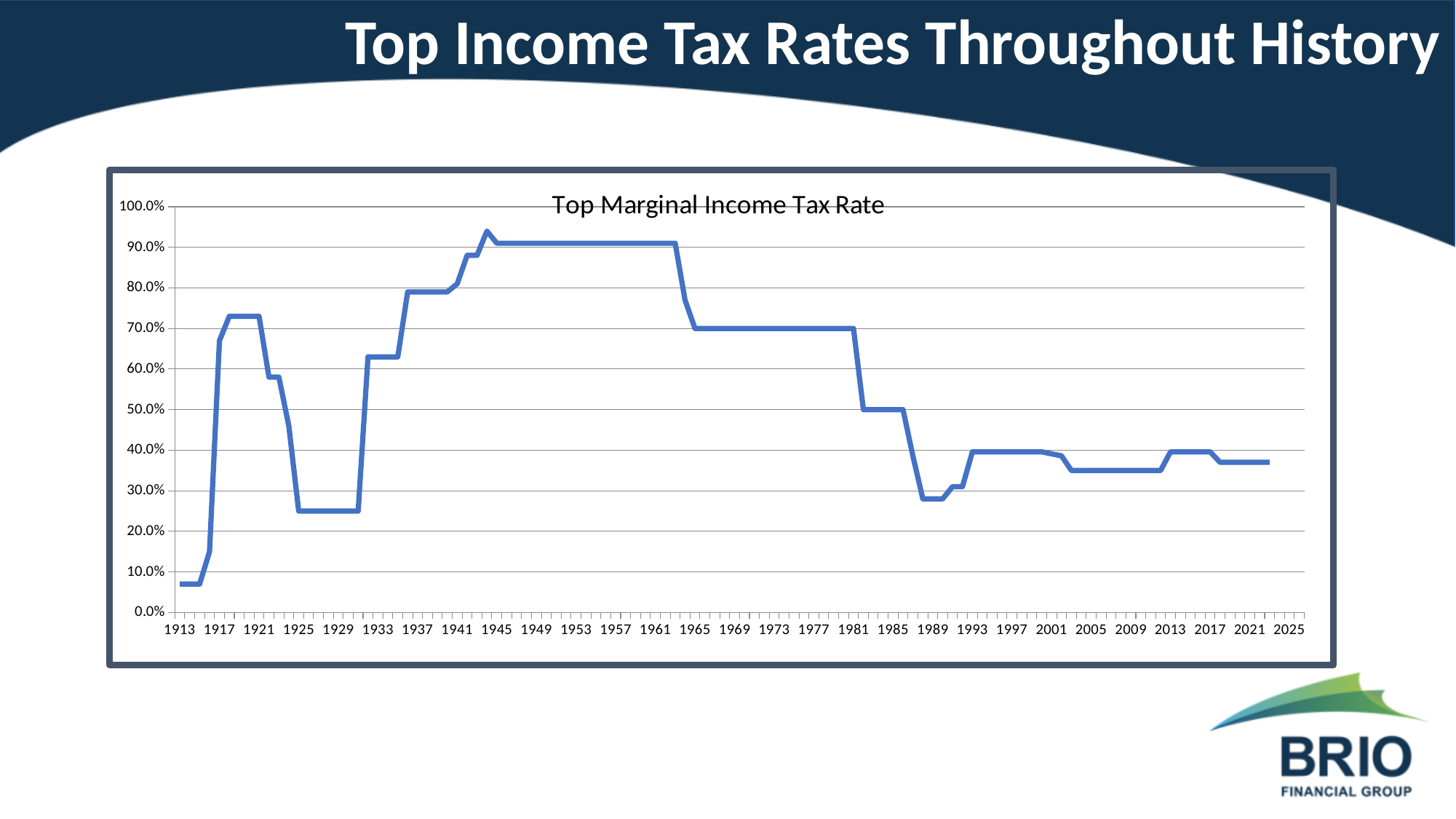
Is the top marginal income tax rate for 1989 greater or less than 30.0%? less Does the top marginal income tax rate rise or fall between 1913 and 1918? rise Is the top marginal income tax rate for 2021 greater or less than 40.0%? less Which year has a higher top marginal income tax rate, 1950 or 1990? 1950 What is the top marginal income tax rate shown for 1970? 70.0% Is the top marginal income tax rate for 1927 greater or less than 30.0%? less What kind of chart is shown on the slide? line chart What is the highest value shown on the vertical axis of the chart? 100.0% Does the top marginal income tax rate rise or fall between 1981 and 1989? fall What is the title of the chart? Top Marginal Income Tax Rate